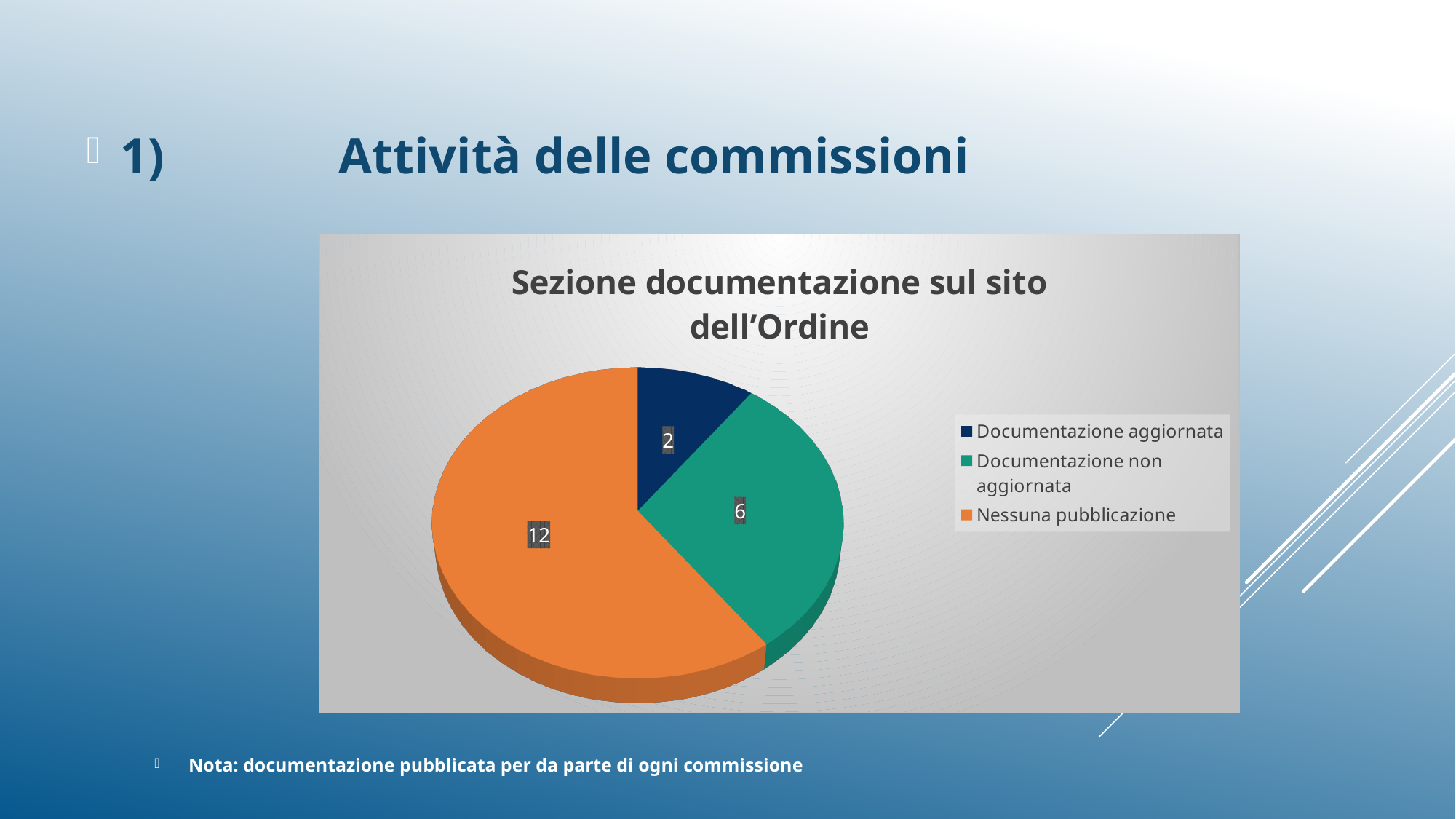
What is the title of the chart? Sezione documentazione sul sito dell'Ordine What is the total of all the slices in the pie chart? 20 Which is larger, Documentazione non aggiornata or Documentazione aggiornata? Documentazione non aggiornata What is the value for Documentazione non aggiornata? 6 Which category has the smallest slice? Documentazione aggiornata How many slices does the pie chart have? 3 What is the difference between the values for Nessuna pubblicazione and Documentazione non aggiornata? 6 Which category has the largest slice? Nessuna pubblicazione What share of the pie does Nessuna pubblicazione represent? 60% What kind of chart is shown on the slide? Pie chart What is the value for Nessuna pubblicazione? 12 What is the value for Documentazione aggiornata? 2